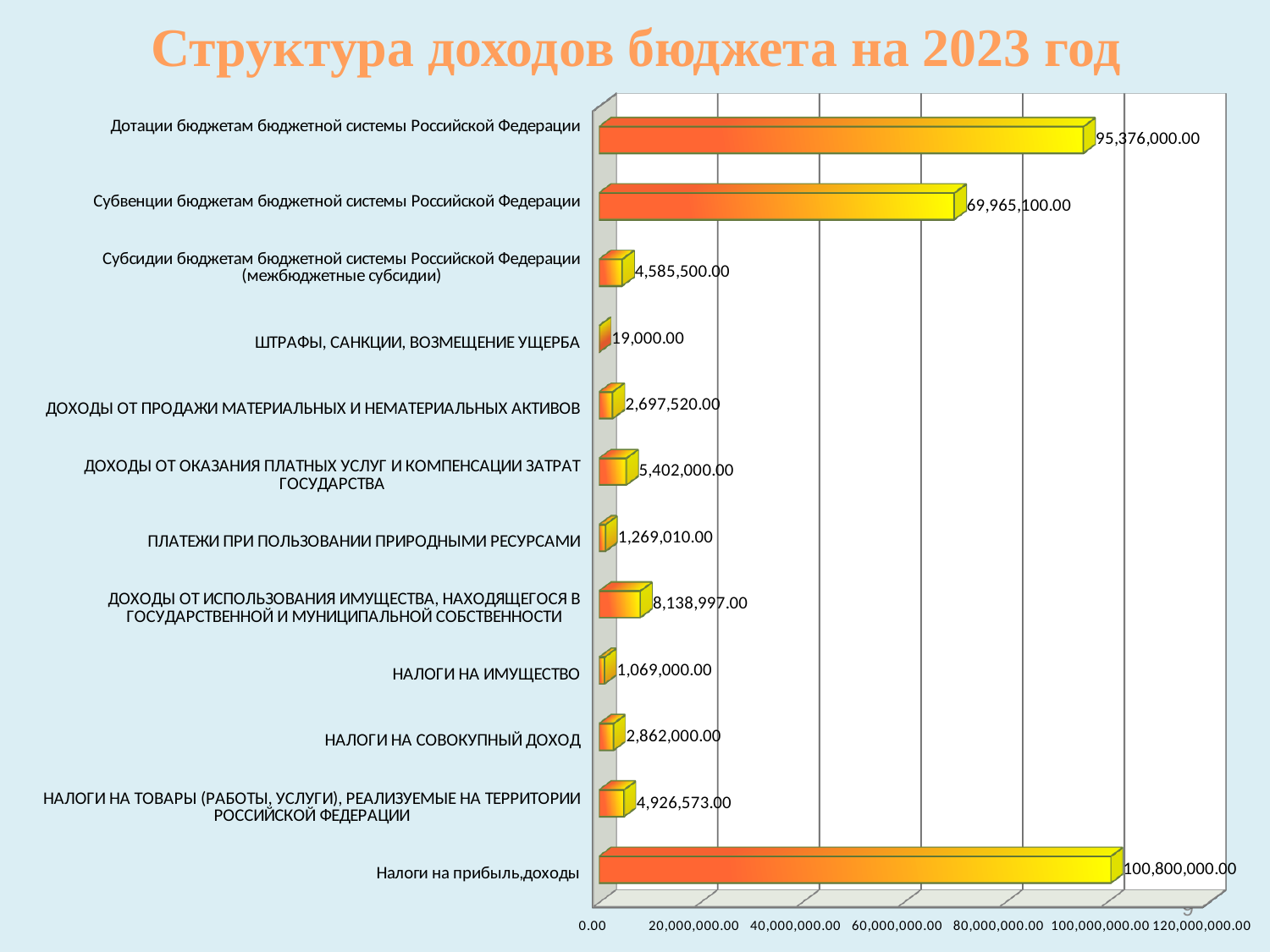
How many categories are shown in the chart? 12 Is the value for Субвенции бюджетам бюджетной системы Российской Федерации greater or less than 60,000,000.00? greater Which category has the lowest value? ШТРАФЫ, САНКЦИИ, ВОЗМЕЩЕНИЕ УЩЕРБА What is the difference between the values for Налоги на прибыль,доходы and Дотации бюджетам бюджетной системы Российской Федерации? 5,424,000.00 What type of chart is shown on the slide? bar chart What is the value for Налоги на прибыль,доходы? 100,800,000.00 What is the value for НАЛОГИ НА СОВОКУПНЫЙ ДОХОД? 2,862,000.00 What is the value for ШТРАФЫ, САНКЦИИ, ВОЗМЕЩЕНИЕ УЩЕРБА? 19,000.00 What is the difference between the values for Дотации бюджетам бюджетной системы Российской Федерации and Субвенции бюджетам бюджетной системы Российской Федерации? 25,410,900.00 What is the value for Дотации бюджетам бюджетной системы Российской Федерации? 95,376,000.00 Which is larger, the value for НАЛОГИ НА ИМУЩЕСТВО or the value for ПЛАТЕЖИ ПРИ ПОЛЬЗОВАНИИ ПРИРОДНЫМИ РЕСУРСАМИ? ПЛАТЕЖИ ПРИ ПОЛЬЗОВАНИИ ПРИРОДНЫМИ РЕСУРСАМИ Which category has the highest value? Налоги на прибыль,доходы